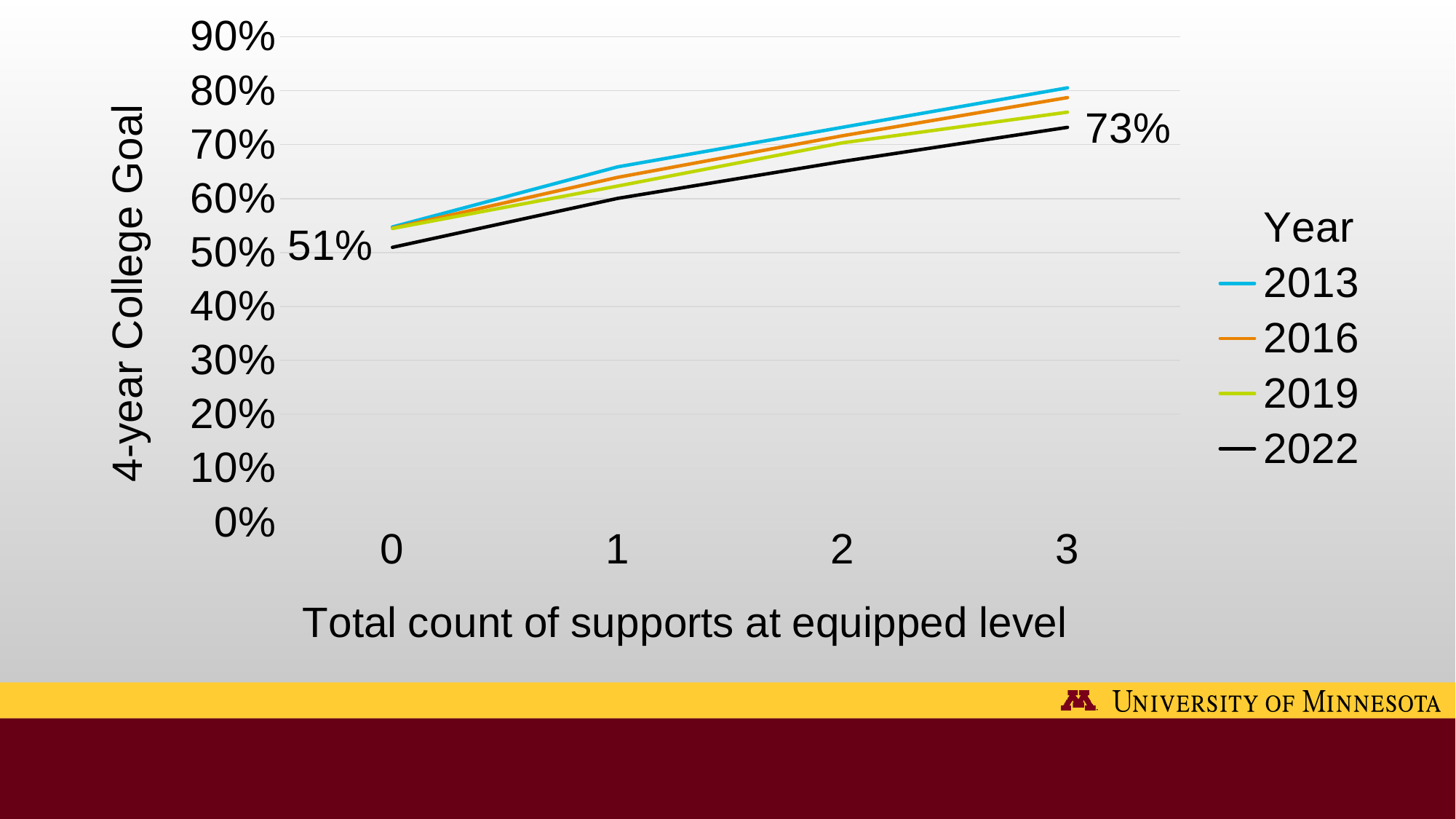
What is the 4-year College Goal value for 2022 at 3 supports? 73% What is the 4-year College Goal value for 2022 at 0 supports? 51% How many series does the legend list? 4 Which is larger at 2 supports, the value for 2013 or the value for 2022? 2013 By how many percentage points does the 2022 line rise from 0 supports to 3 supports? 22 percentage points What kind of chart is shown on the slide? line chart Which year has the lowest 4-year College Goal value at 0 supports? 2022 Do the lines rise or fall as the total count of supports increases from 0 to 3? rise Which year has the lowest 4-year College Goal value at 3 supports? 2022 Is the value for 2013 at 3 supports greater or less than 70%? greater How many values of 'Total count of supports at equipped level' are shown on the x axis? 4 What is the title of the legend? Year